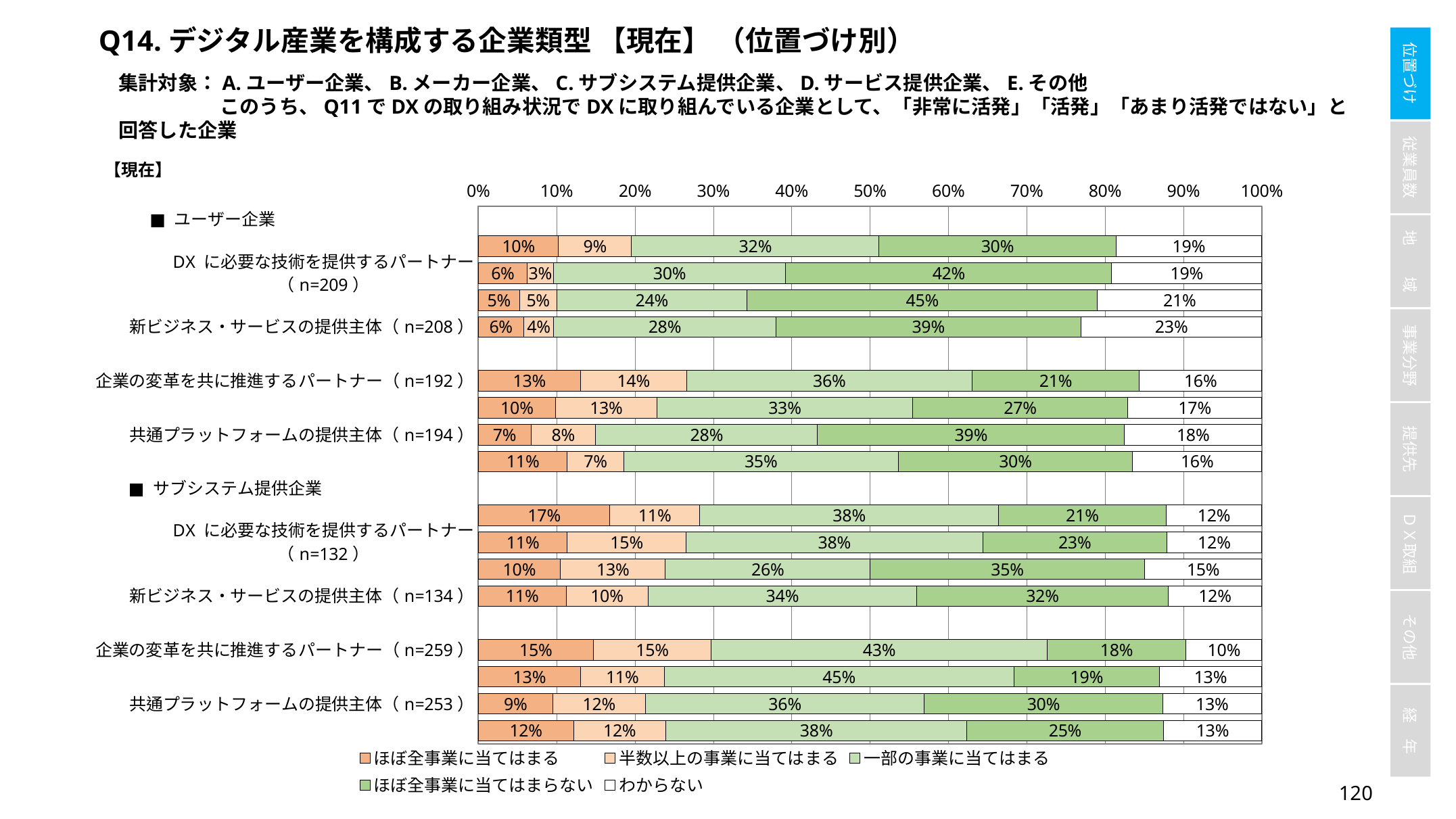
In the ユーザー企業 group, what is the total of the stacked bar for 企業の変革を共に推進するパートナー (n=192)? 100% What kind of chart is shown on the slide? Stacked bar chart In the サブシステム提供企業 group, what is the ほぼ全事業に当てはまる value for 企業の変革を共に推進するパートナー (n=259)? 15% In the サブシステム提供企業 group, what is the ほぼ全事業に当てはまらない value for 共通プラットフォームの提供主体 (n=253)? 30% What colour represents わからない in the legend? White In the サブシステム提供企業 group, for 新ビジネス・サービスの提供主体 (n=134), which is larger: 一部の事業に当てはまる or ほぼ全事業に当てはまらない? 一部の事業に当てはまる In the ユーザー企業 group, what is the 一部の事業に当てはまる value for 企業の変革を共に推進するパートナー (n=192)? 36% In the ユーザー企業 group, for 共通プラットフォームの提供主体 (n=194), how much larger is ほぼ全事業に当てはまらない than ほぼ全事業に当てはまる? 32 percentage points How many series does the legend list? 5 In the サブシステム提供企業 group, what is the わからない value for 企業の変革を共に推進するパートナー (n=259)? 10% What is the maximum value shown on the horizontal axis? 100% In the ユーザー企業 group, what is the わからない value for 新ビジネス・サービスの提供主体 (n=208)? 23%